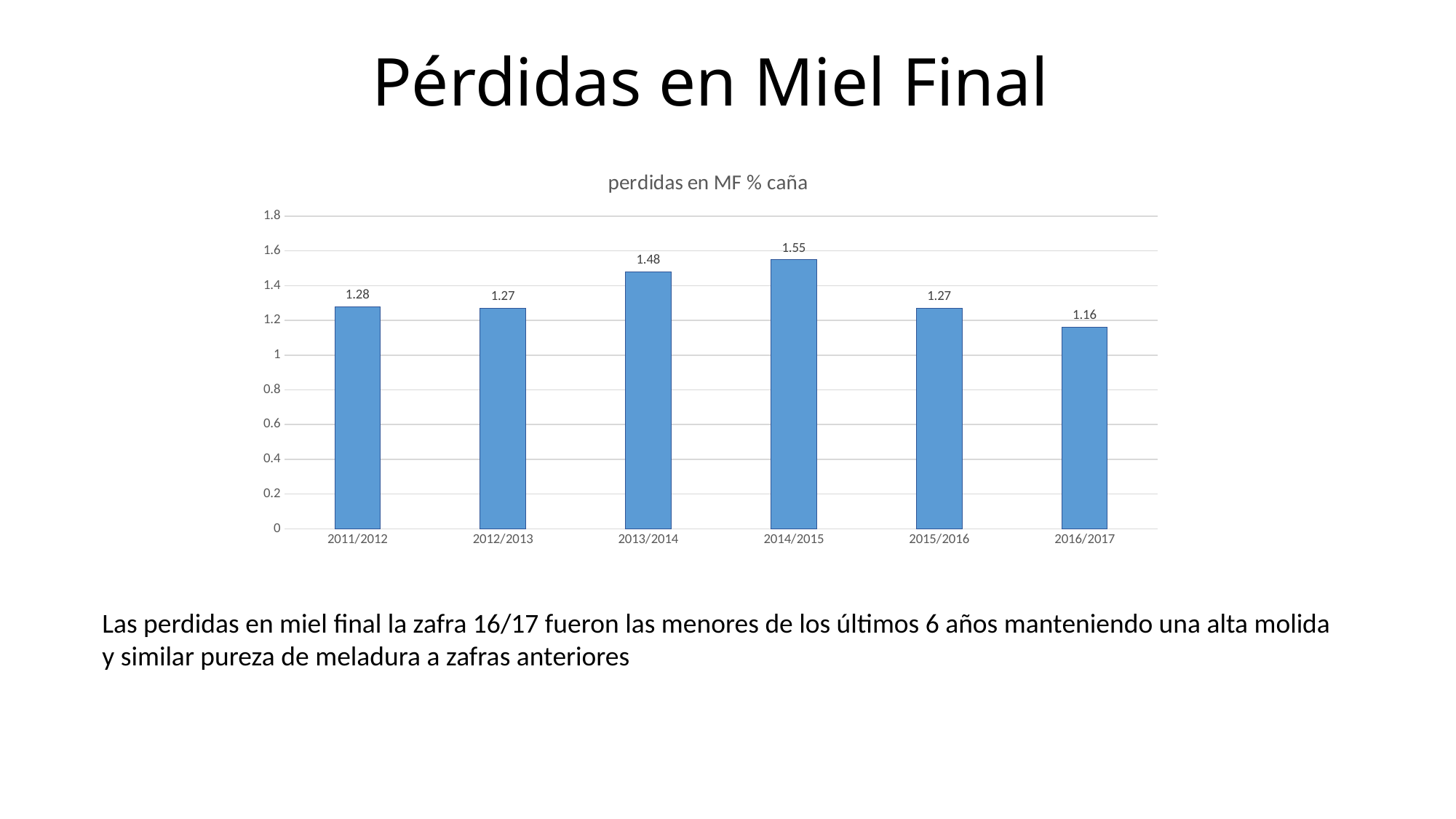
Which season has the lowest value? 2016/2017 Which season has the highest value? 2014/2015 Which is larger, the value for 2013/2014 or the value for 2011/2012? 2013/2014 What is the value for 2014/2015? 1.55 What is the value for 2013/2014? 1.48 How many seasons are shown on the x axis? 6 What kind of chart is this? bar chart What is the value for 2016/2017? 1.16 What is the title of the chart? perdidas en MF % caña Is the value for 2014/2015 greater or less than 1.4? greater Do the values rise or fall from 2014/2015 to 2016/2017? fall What is the difference between the values for 2014/2015 and 2016/2017? 0.39